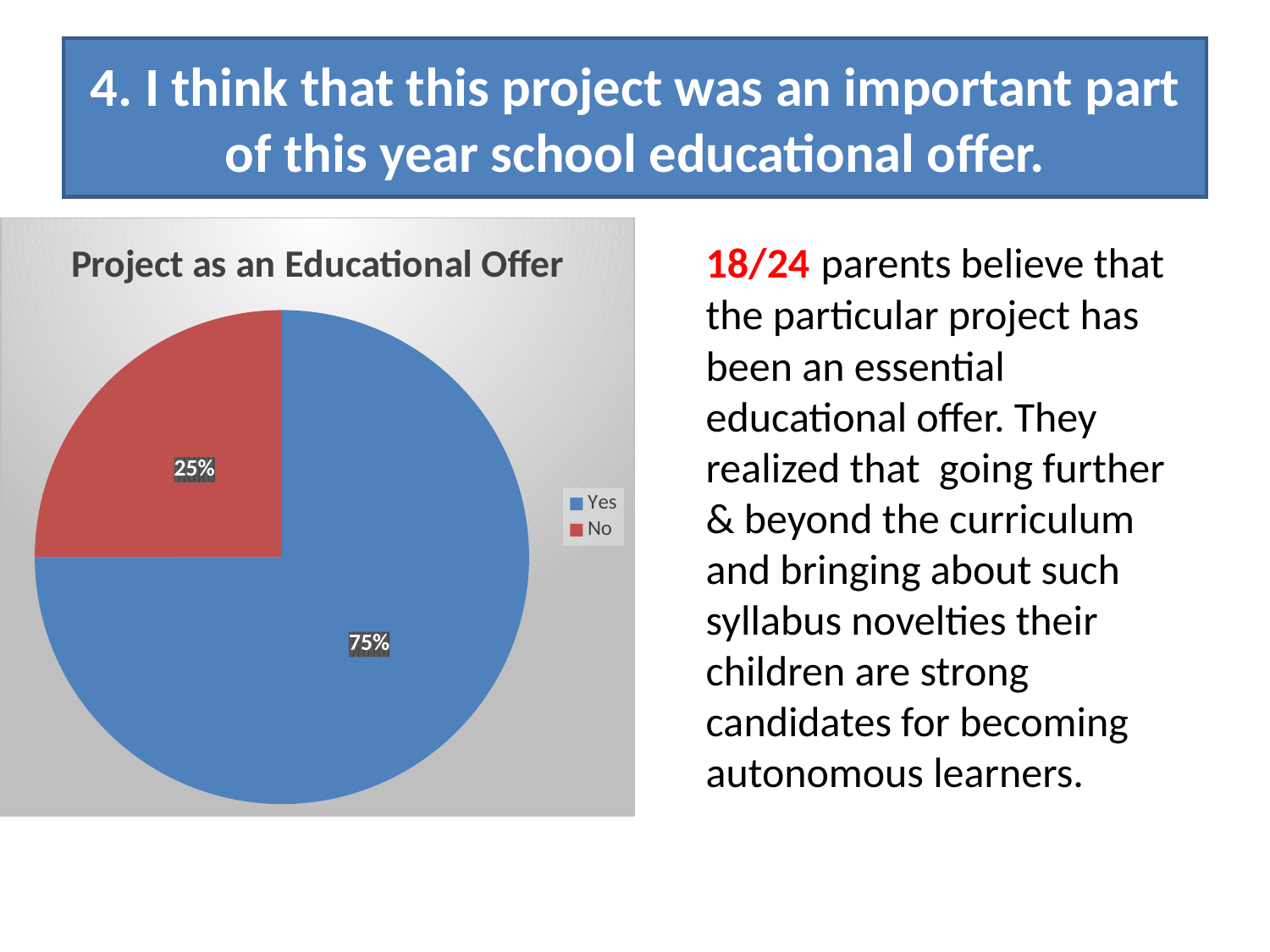
What share of the pie does the Yes slice represent? 75% What share of the pie does the No slice represent? 25% Which category has the largest slice of the pie? Yes Which slice is larger, Yes or No? Yes What is the difference in percentage points between the Yes and No slices? 50% How many categories does the pie chart show? 2 What colour is the Yes slice in the pie chart? blue What is the title of the pie chart? Project as an Educational Offer How many entries does the legend list? 2 What type of chart is shown on the slide? pie chart Which category has the smallest slice of the pie? No